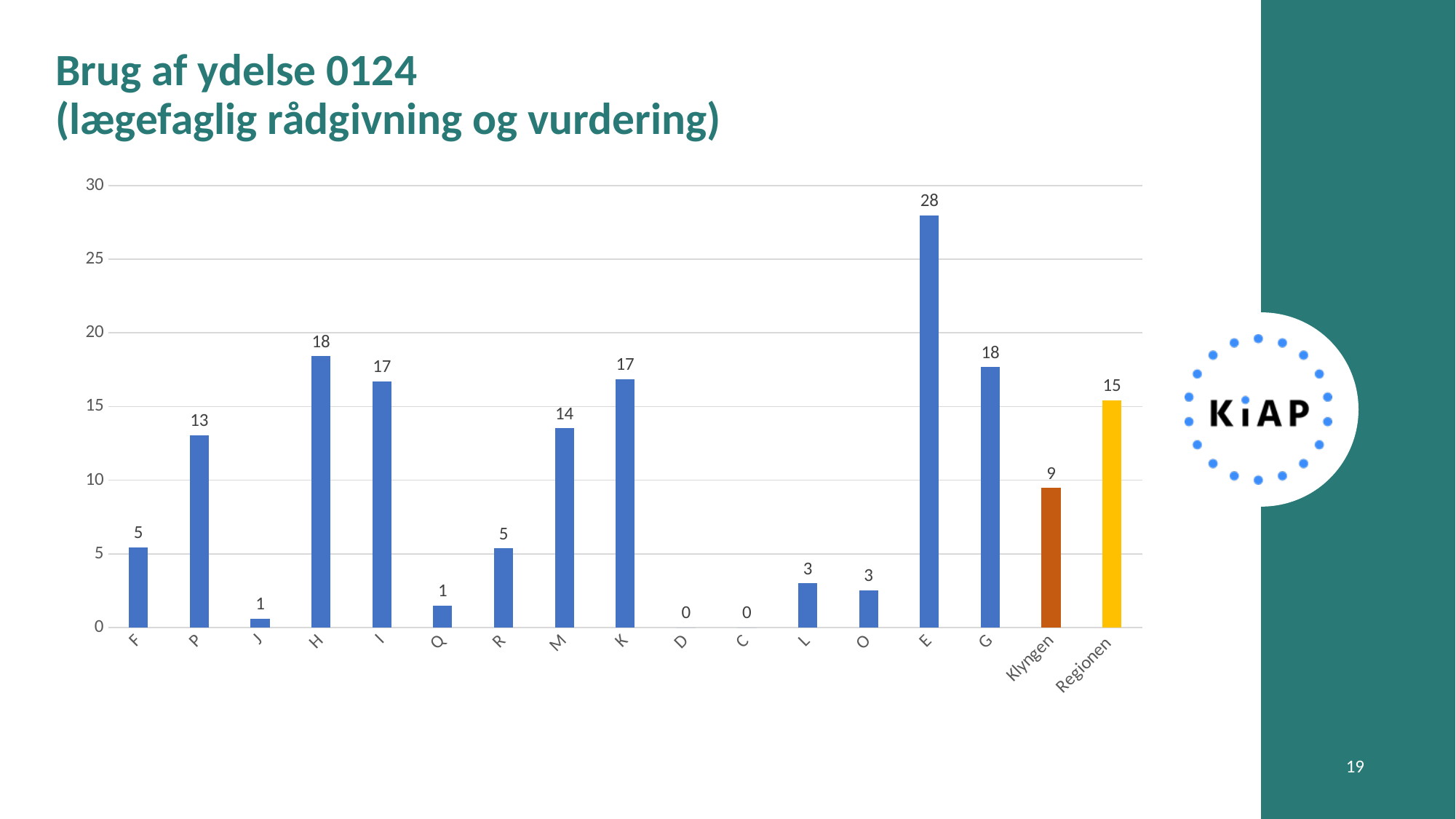
What kind of chart is shown on the slide? Bar chart Which is larger, the value for Klyngen or the value for Regionen? Regionen What is the difference between the values for Regionen and Klyngen? 6 What is the difference between the values for E and G? 10 What is the value for P? 13 Which category has the highest value? E How many categories are shown on the x axis? 17 Is the value for P greater or less than 10? greater What is the value for E? 28 Which is larger, the value for H or the value for M? H What is the value for Regionen? 15 What is the value for Klyngen? 9